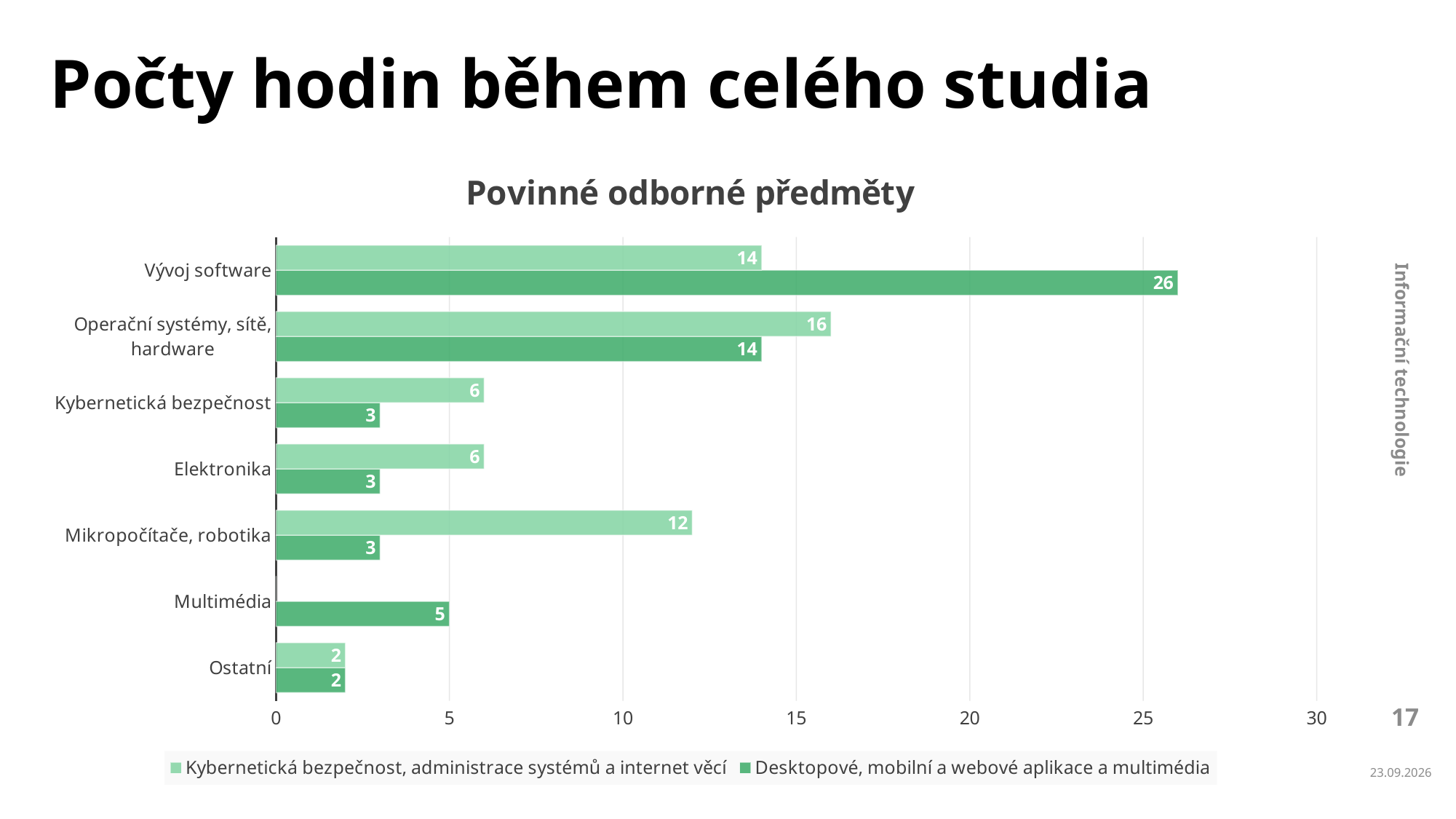
What is the title of the chart? Povinné odborné předměty What is the value for Ostatní in the series Kybernetická bezpečnost, administrace systémů a internet věcí? 2 For Mikropočítače, robotika, which series has the larger value? Kybernetická bezpečnost, administrace systémů a internet věcí Which category has the lowest value in the series Kybernetická bezpečnost, administrace systémů a internet věcí? Multimédia What is the value for Multimédia in the series Desktopové, mobilní a webové aplikace a multimédia? 5 What type of chart is shown on the slide? bar chart Which category has the highest value in the series Desktopové, mobilní a webové aplikace a multimédia? Vývoj software What is the value for Operační systémy, sítě, hardware in the series Kybernetická bezpečnost, administrace systémů a internet věcí? 16 What is the value for Vývoj software in the series Desktopové, mobilní a webové aplikace a multimédia? 26 How many categories are shown on the vertical axis? 7 How many series does the legend list? 2 What is the difference between the two series' values for Vývoj software? 12